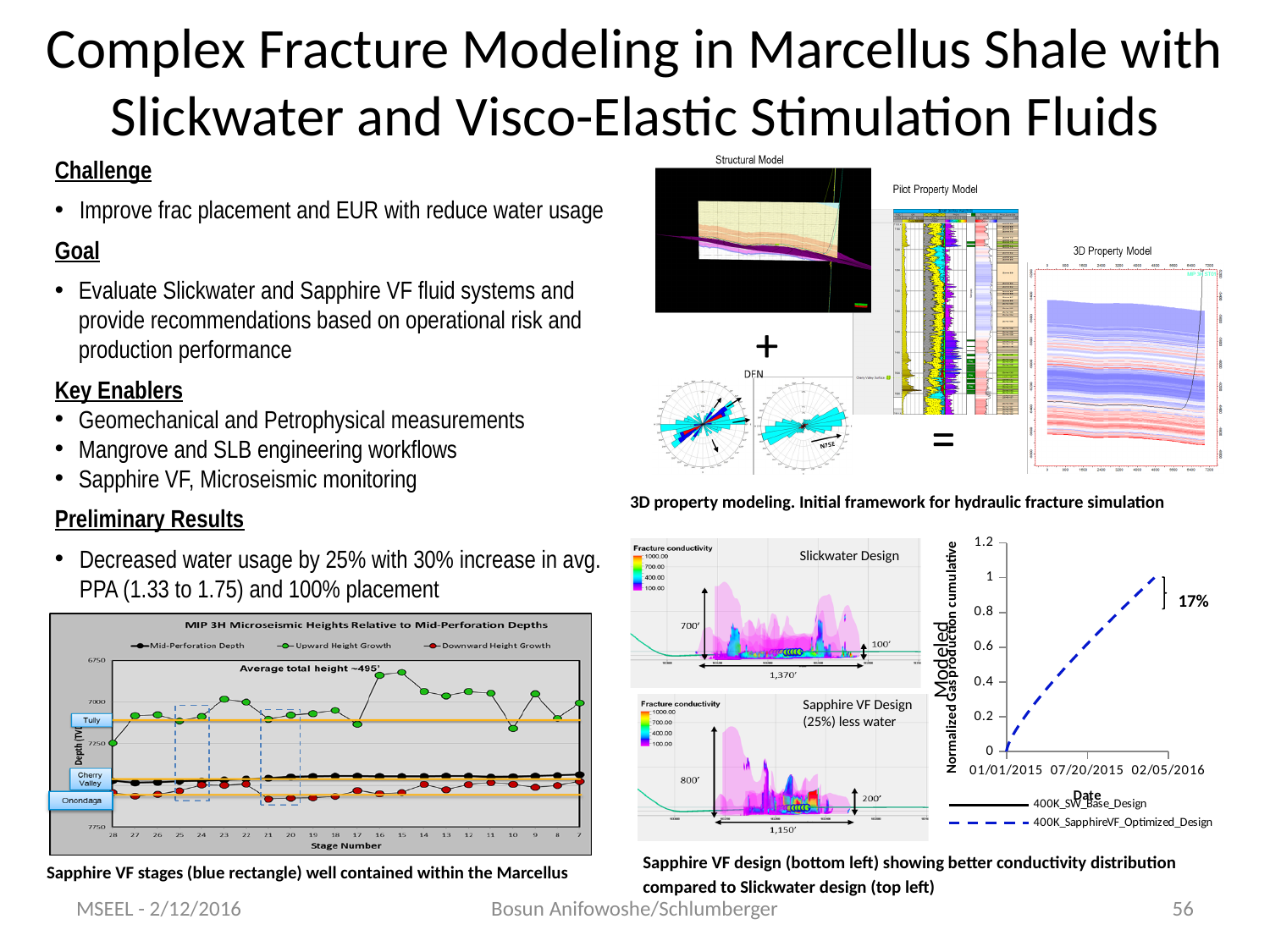
What percentage is annotated next to the end of the curve in the bottom-right normalized gas production chart? 17% What is the highest tick value on the y axis of the bottom-right normalized gas production chart? 1.2 What are the two legend entries of the bottom-right normalized gas production chart? 400K_SW_Base_Design and 400K_SapphireVF_Optimized_Design In the bottom-left microseismic heights chart, is the Mid-Perforation Depth at stage 7 greater or less than 7250? greater How many stage numbers are shown on the x axis of the bottom-left microseismic heights chart? 22 What average total height is annotated on the bottom-left microseismic heights chart? ~495' In the bottom-right normalized gas production chart, does the dashed 400K_SapphireVF_Optimized_Design line rise or fall over time? rises What is the last date shown on the x axis of the bottom-right normalized gas production chart? 02/05/2016 What is the title of the bottom-left microseismic chart? MIP 3H Microseismic Heights Relative to Mid-Perforation Depths What kind of chart is the bottom-right chart of normalized gas production cumulative? line chart How many series does the legend of the bottom-right normalized gas production chart list? 2 How many series does the legend of the bottom-left microseismic heights chart list? 3